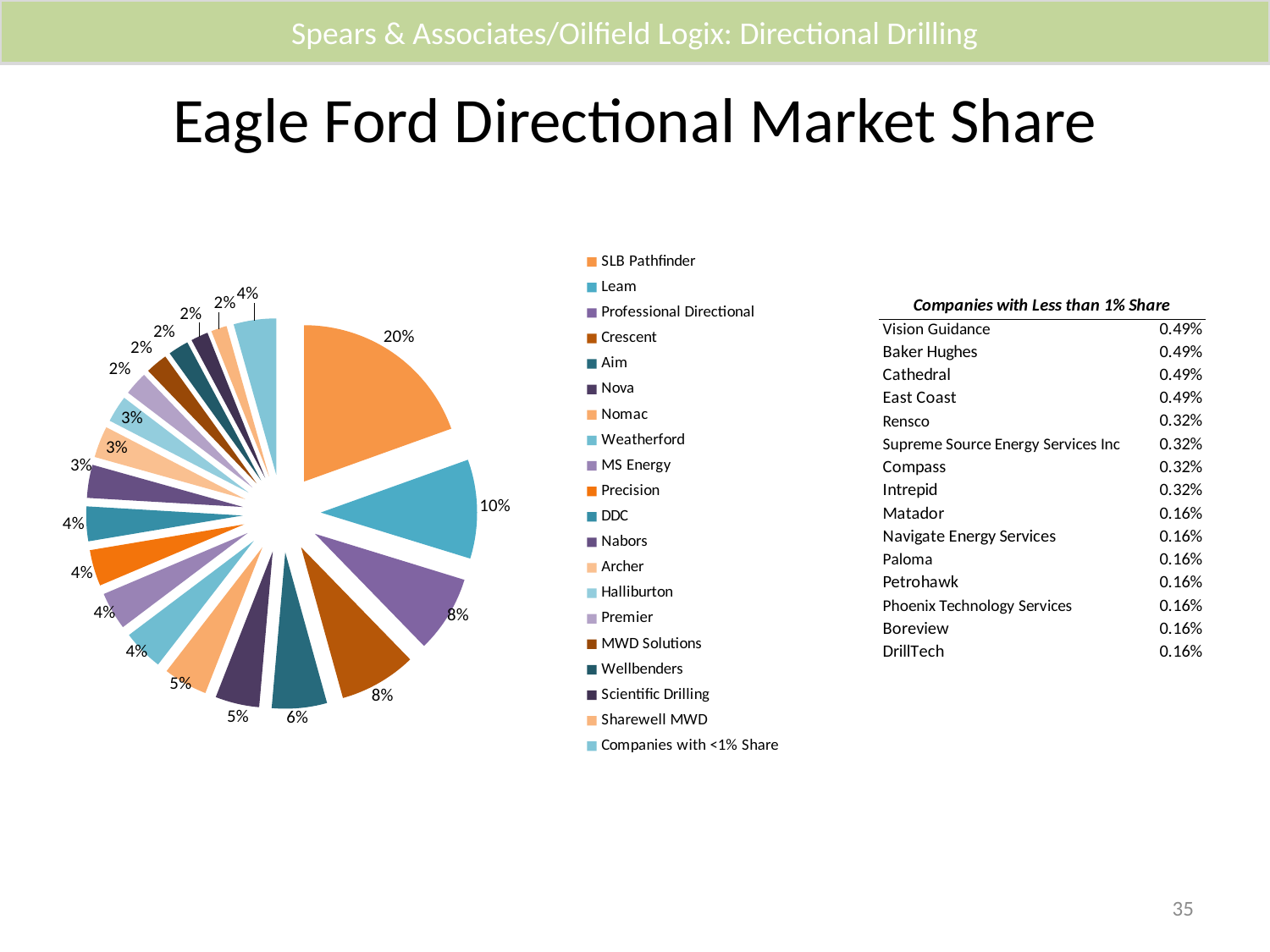
Which has the larger share, Leam or Aim? Leam What is the share shown for Companies with <1% Share? 4% Which legend entry is listed first in the pie chart's legend? SLB Pathfinder What kind of chart is shown on the slide? Pie chart How many entries does the legend of the pie chart list? 20 What is the share shown for Aim? 6% Which company has the largest share in the pie chart? SLB Pathfinder What share of the pie does Leam hold? 10% What is the difference in percentage points between SLB Pathfinder's share and Leam's share? 10 percentage points What share of the pie does SLB Pathfinder hold? 20% What is the title of the chart? Eagle Ford Directional Market Share What is the share shown for Professional Directional? 8%